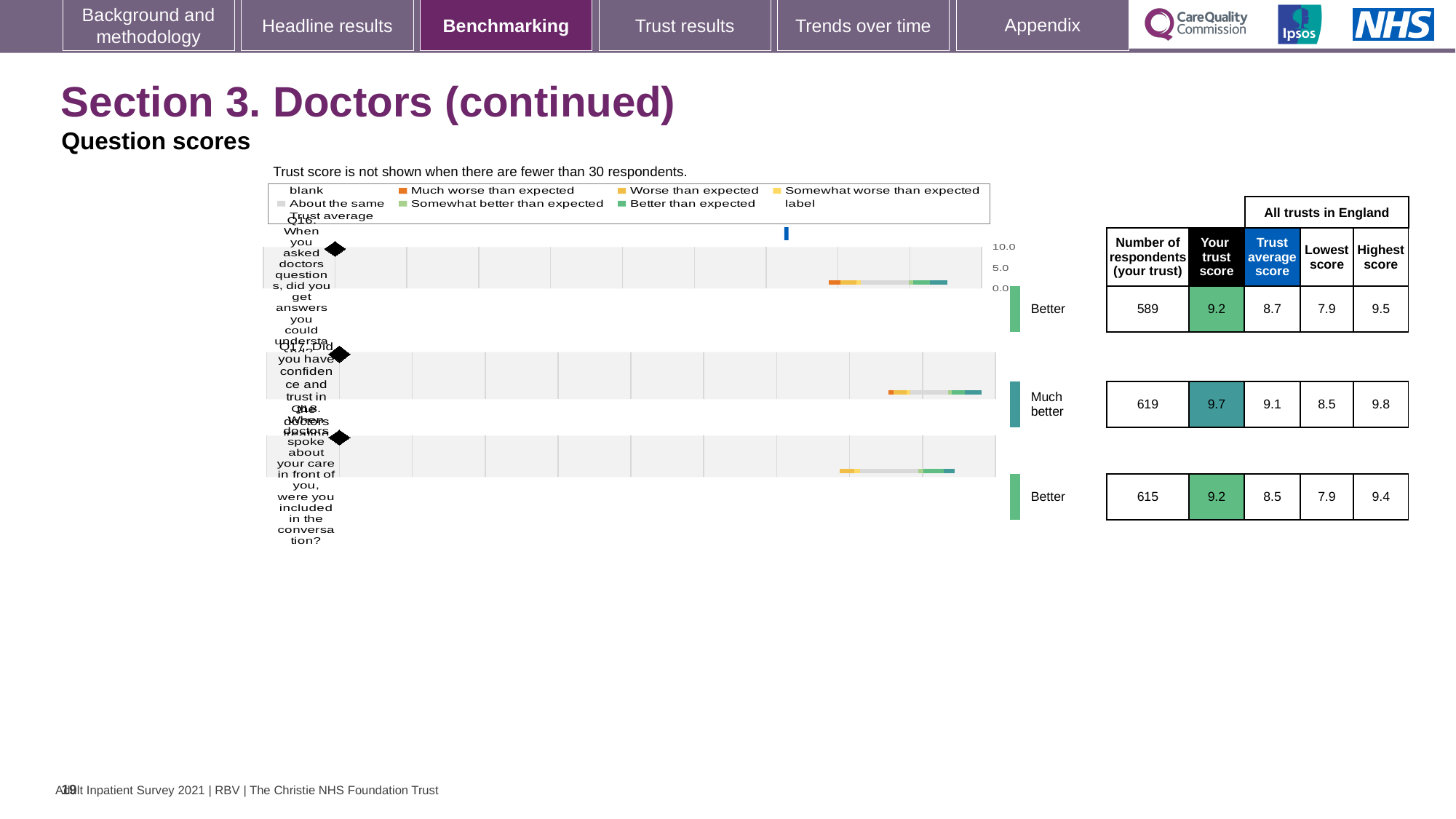
What is the difference between the highest and lowest scores for Q18? 1.5 What is the difference between the trust score and the trust average score for Q17? 0.6 What is the maximum value shown on the chart's score axis? 10.0 For Q16, which is larger: the trust score or the trust average score? the trust score (9.2) What rating label is shown next to the Q17 bar? Much better What kind of chart is used to show the question scores on this slide? bar chart How many respondents answered Q16 (did you get answers you could understand)? 589 How many questions (categories) are plotted in the question scores chart? 3 Which question has the highest trust score? Q17 What is the trust score for Q17 (confidence and trust in the doctors)? 9.7 What is the lowest score across all trusts in England for Q17? 8.5 What is the highest score across all trusts in England for Q18 (were you included in the conversation)? 9.4